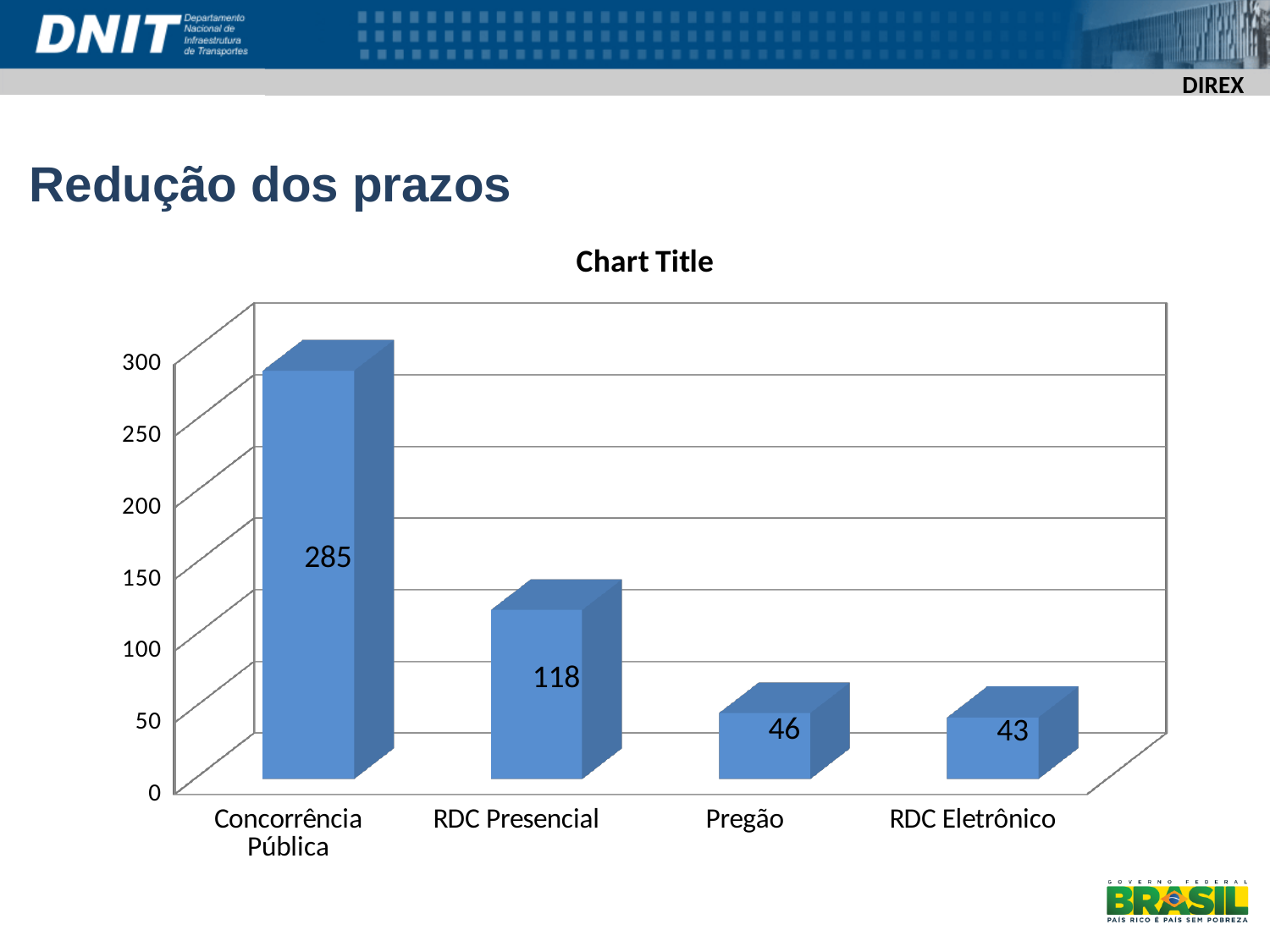
What is the value for RDC Presencial? 118 What is the difference between the values for Pregão and RDC Eletrônico? 3 Which category has the highest value? Concorrência Pública What is the difference between the values for Concorrência Pública and RDC Presencial? 167 What is the value for Pregão? 46 What is the value for RDC Eletrônico? 43 What is the value for Concorrência Pública? 285 Do the values rise or fall from left to right across the categories? Fall Which category has the lowest value? RDC Eletrônico Which is larger, the value for RDC Presencial or the value for Pregão? RDC Presencial What kind of chart is shown on the slide? Bar chart How many categories are shown in the chart? 4